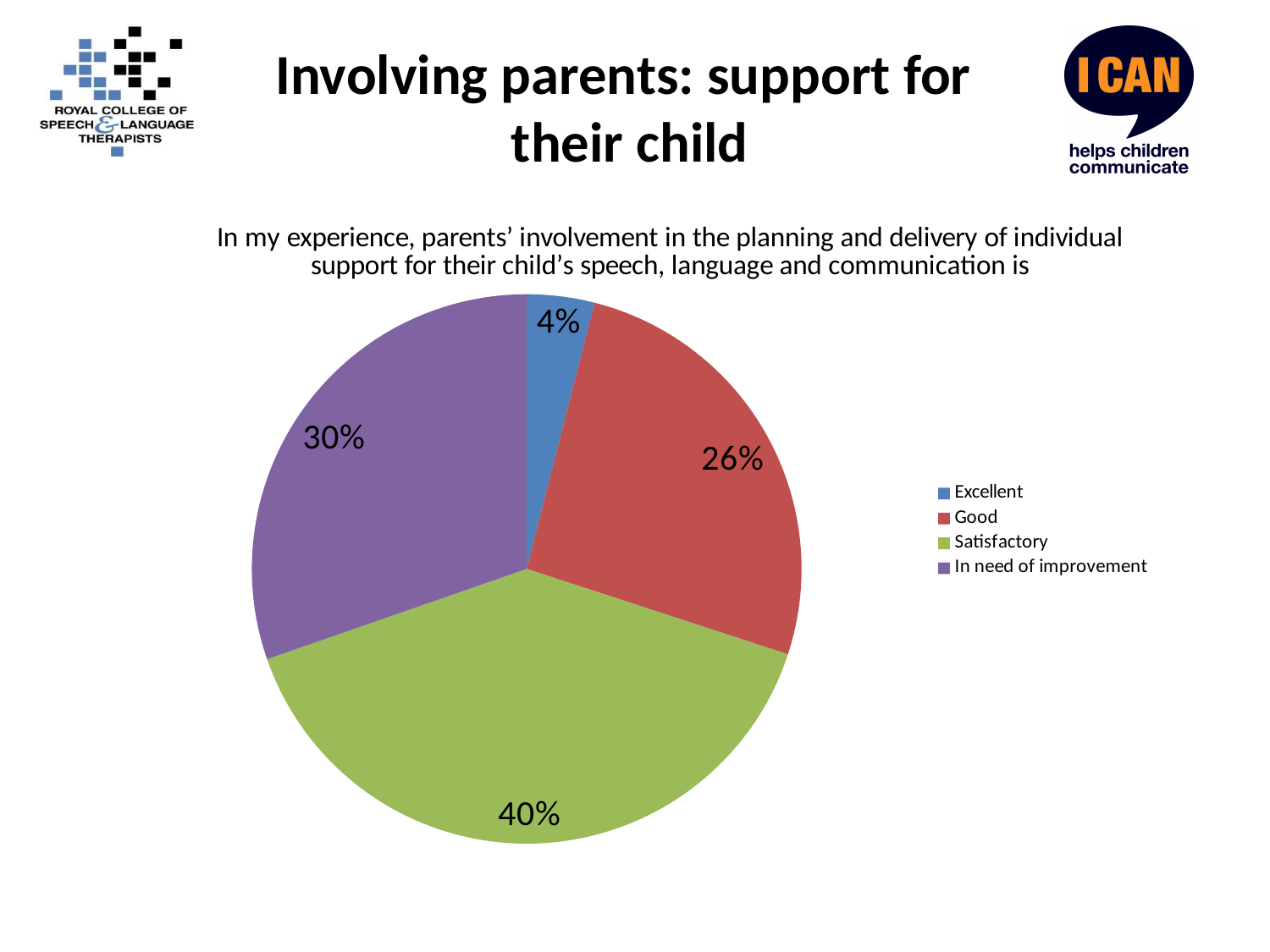
What percentage of respondents rated parents' involvement as In need of improvement? 30% What colour is the Satisfactory slice? green What is the combined share of the Excellent and Good slices? 30% Which rating category has the smallest share of the pie? Excellent How many categories does the pie chart show? 4 What kind of chart is shown on the slide? pie chart What percentage of respondents rated parents' involvement as Excellent? 4% What percentage of respondents rated parents' involvement as Good? 26% Which is larger, the share for In need of improvement or the share for Good? In need of improvement What percentage of respondents rated parents' involvement as Satisfactory? 40% Which rating category has the largest share of the pie? Satisfactory What is the difference in percentage points between the Satisfactory and Good slices? 14